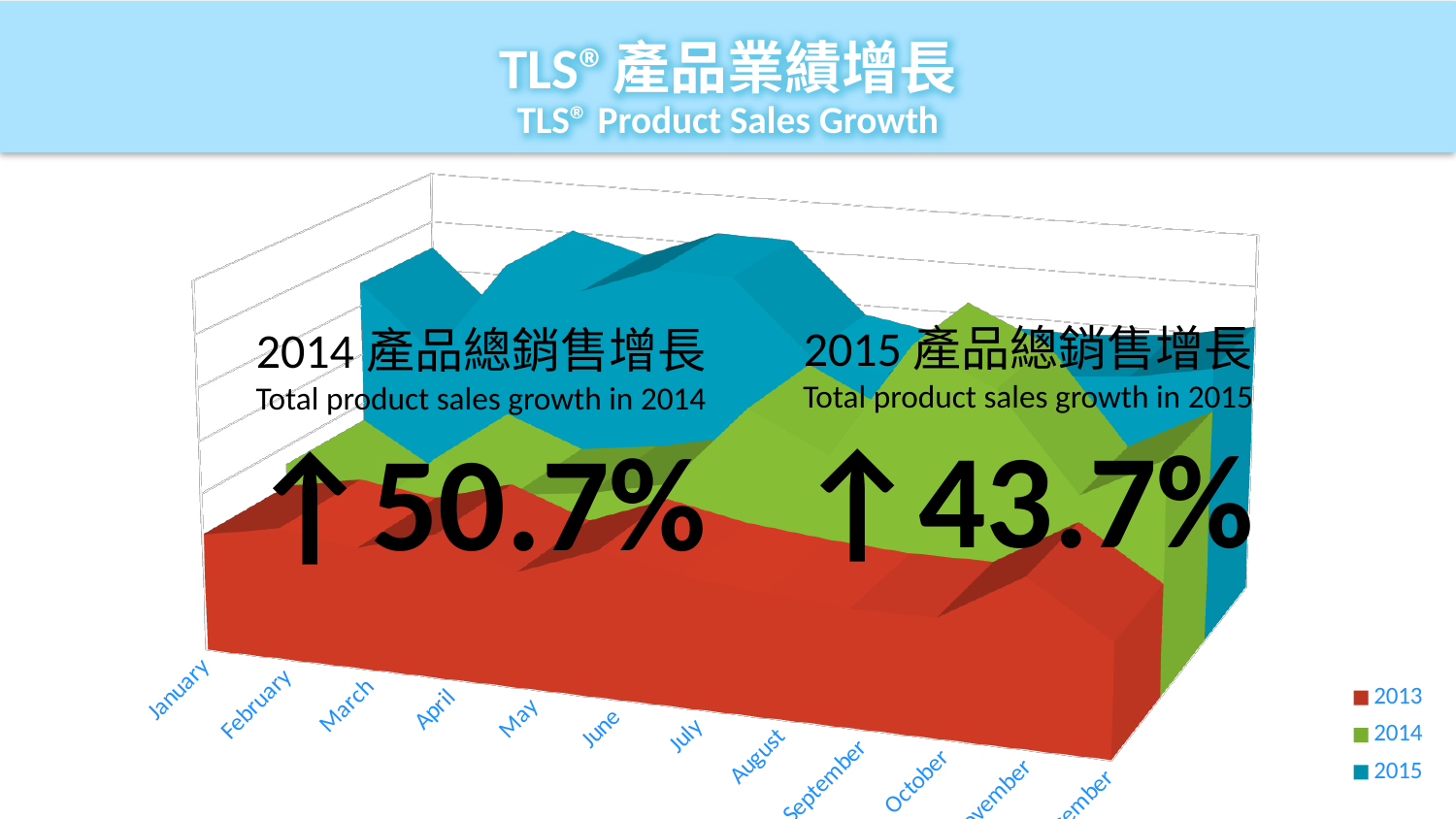
How many months are shown along the x axis? 12 What kind of chart is shown on the slide? Area chart What total product sales growth is stated for 2014? ↑50.7% What is the first month shown on the x axis? January What is the last month shown on the x axis? December How many series does the legend list? 3 What total product sales growth is stated for 2015? ↑43.7% Which year had the higher stated total product sales growth, 2014 or 2015? 2014 Which years are listed in the legend? 2013, 2014, 2015 What is the English title of the chart slide? TLS® Product Sales Growth What is the difference between the stated total product sales growth in 2014 and in 2015? 7.0%